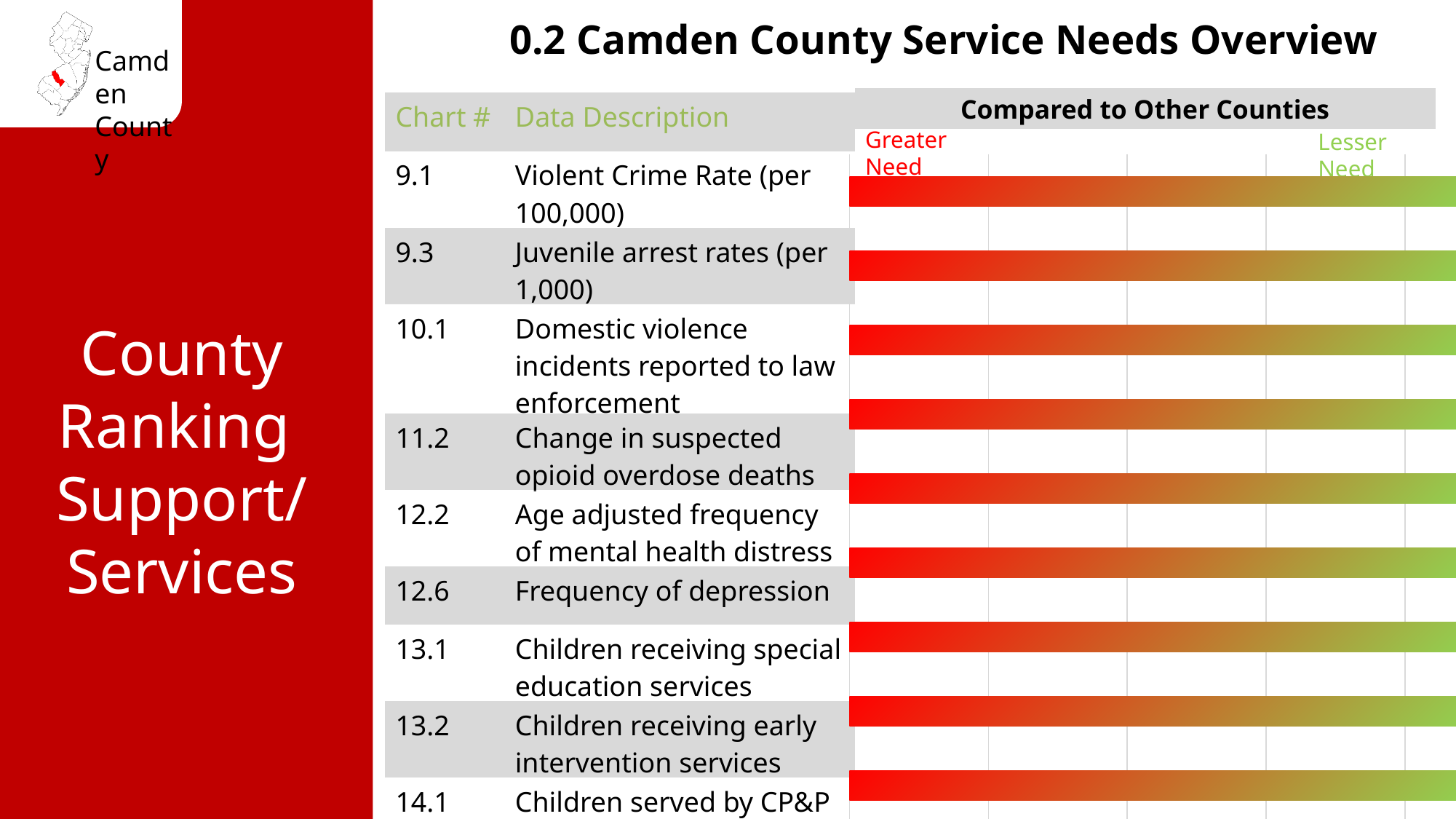
How many bars are plotted in the "Compared to Other Counties" chart? 9 What is the data description for chart # 14.1? Children served by CP&P What label appears at the left end of the bar scale, and what label appears at the right end? Greater Need (left), Lesser Need (right) What is the title of the slide containing the chart? 0.2 Camden County Service Needs Overview Which chart # corresponds to "Change in suspected opioid overdose deaths"? 11.2 What kind of chart is shown under "Compared to Other Counties"? bar chart Which chart # corresponds to "Juvenile arrest rates (per 1,000)"? 9.3 What is the data description for chart # 13.2? Children receiving early intervention services How many rows (chart numbers) are listed in the table on the slide? 9 What is the data description for chart # 12.6? Frequency of depression